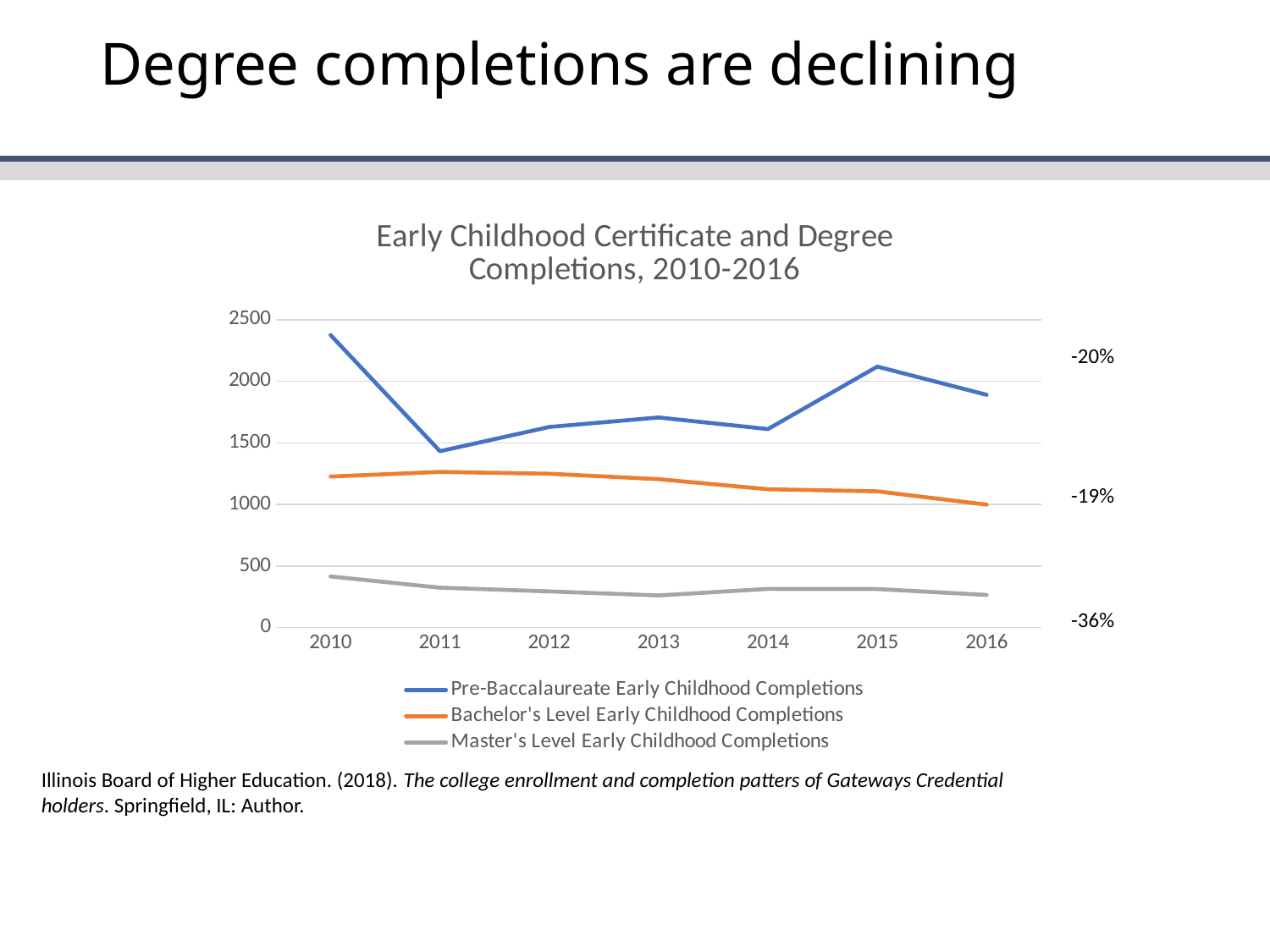
Do Bachelor's Level Early Childhood Completions rise or fall from 2012 to 2016? fall In which year is Pre-Baccalaureate Early Childhood Completions lowest? 2011 Which percentage change is printed next to the Master's Level Early Childhood Completions line? -36% What kind of chart is shown on the slide? line chart In which year is Pre-Baccalaureate Early Childhood Completions highest? 2010 Is the value for Pre-Baccalaureate Early Childhood Completions in 2010 greater or less than 2000? greater Which series has the larger value in 2010, Pre-Baccalaureate Early Childhood Completions or Bachelor's Level Early Childhood Completions? Pre-Baccalaureate Early Childhood Completions Is the value for Master's Level Early Childhood Completions in 2010 greater or less than 500? less How many years are plotted along the x axis? 7 What is the title of the chart? Early Childhood Certificate and Degree Completions, 2010-2016 How many series does the legend list? 3 In which year is Bachelor's Level Early Childhood Completions lowest? 2016